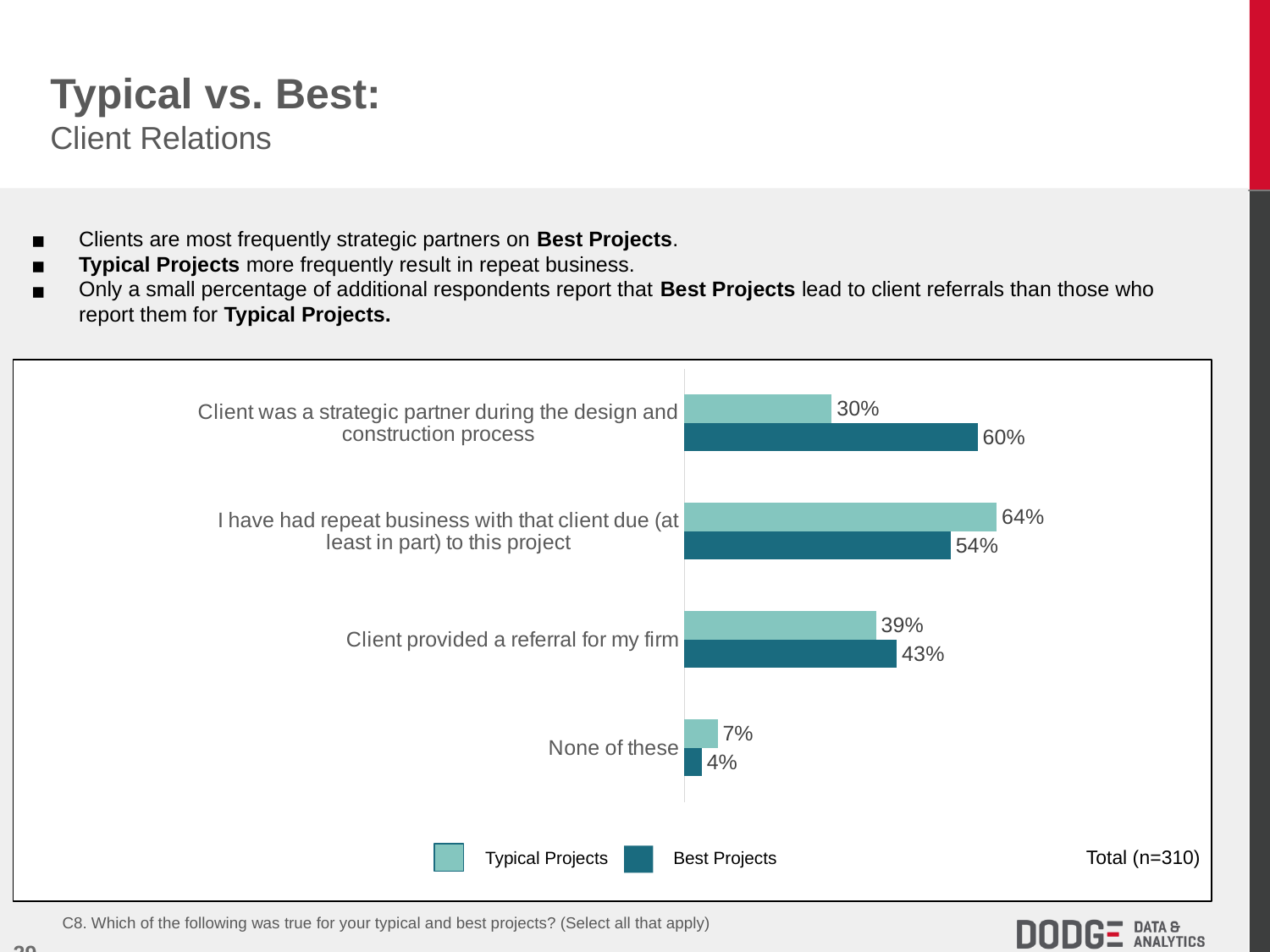
Which category has the lowest value for Best Projects? None of these What is the Typical Projects value for 'Client provided a referral for my firm'? 39% What percentage of Best Projects had the client as a strategic partner during the design and construction process? 60% What type of chart is shown on the slide? Bar chart What percentage of Typical Projects had the client as a strategic partner during the design and construction process? 30% What is the Best Projects value for 'I have had repeat business with that client due (at least in part) to this project'? 54% What is the difference between the Best Projects and Typical Projects values for 'Client was a strategic partner during the design and construction process'? 30% Which category has the highest value for Typical Projects? I have had repeat business with that client due (at least in part) to this project For 'Client provided a referral for my firm', which is larger: Typical Projects or Best Projects? Best Projects What is the total sample size shown on the chart? n=310 How many categories are shown in the chart? 4 How many series does the legend list? 2